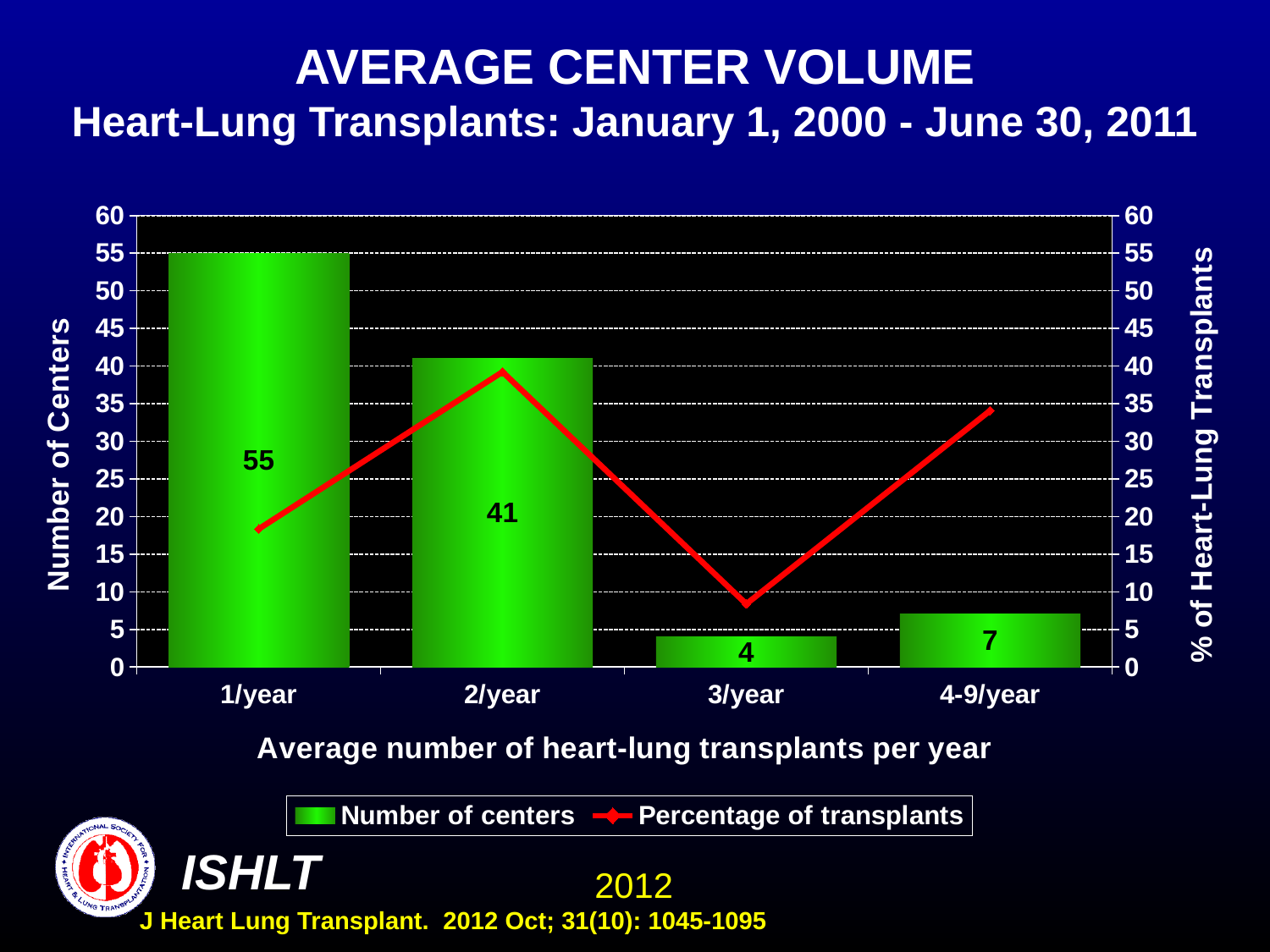
Is the percentage of transplants for the 2/year category greater or less than 35? greater What is the difference in number of centers between the 1/year and 2/year categories? 14 How many series does the legend list? 2 What is the number of centers for the 1/year category? 55 How many categories are shown on the x axis? 4 What is the number of centers for the 4-9/year category? 7 What is the number of centers for the 3/year category? 4 Is the percentage of transplants for the 3/year category greater or less than 10? less Which has more centers, the 3/year category or the 4-9/year category? 4-9/year Which category has the lowest number of centers? 3/year Which category has the highest number of centers? 1/year What is the number of centers for the 2/year category? 41